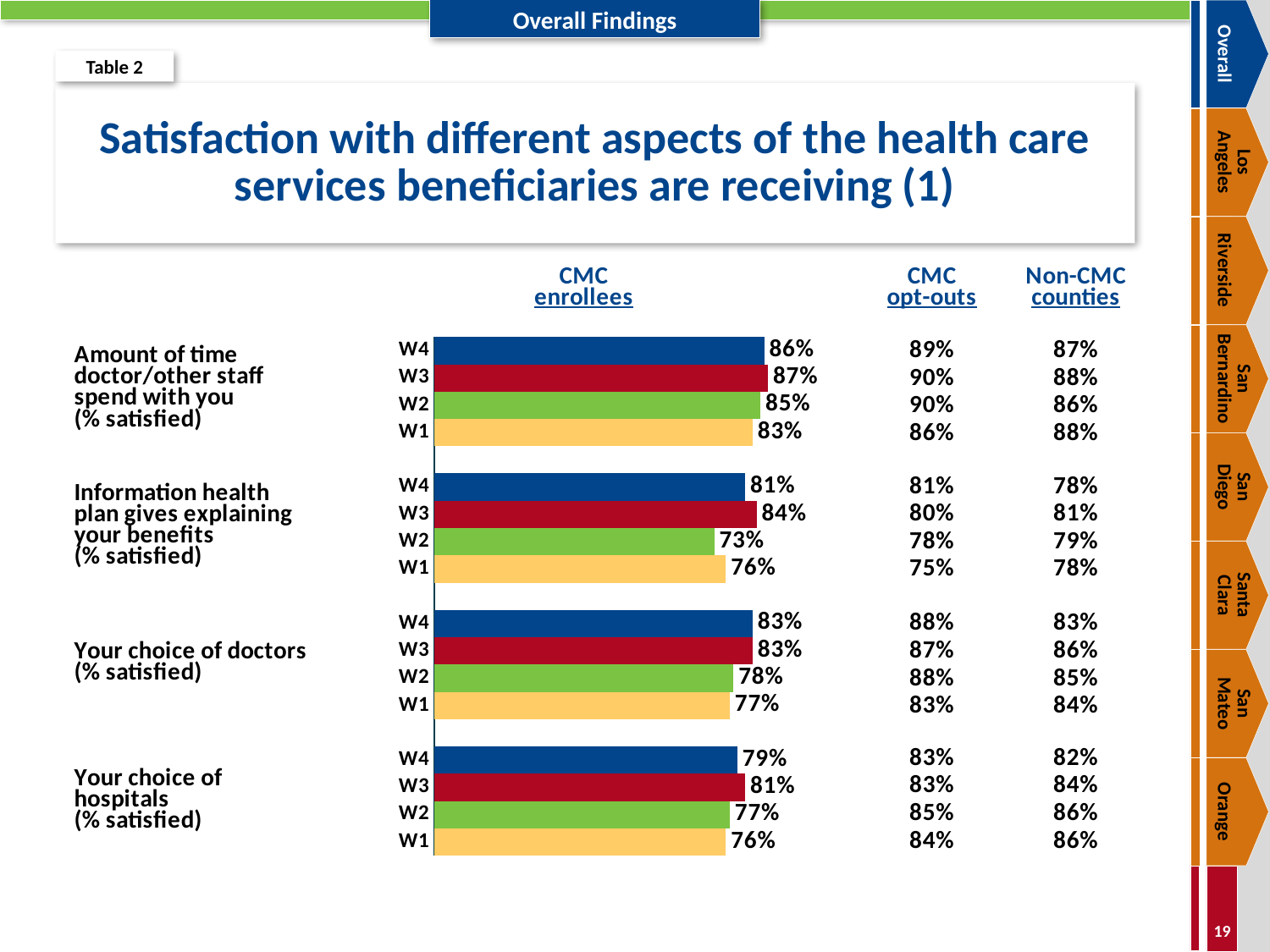
How many waves (bars) are shown for each aspect in the CMC enrollees chart? 4 What colour are the W3 bars in the CMC enrollees chart? Red What is the CMC enrollees value for W2 under "Information health plan gives explaining your benefits"? 73% For "Amount of time doctor/other staff spend with you", what is the difference between the W3 and W1 CMC enrollees values? 4 percentage points Which is larger for CMC enrollees at W4: "Your choice of doctors" or "Your choice of hospitals"? Your choice of doctors What kind of chart is used to show the CMC enrollees values? Bar chart For "Your choice of hospitals", which wave has the highest CMC enrollees bar? W3 For "Information health plan gives explaining your benefits", how much higher is the W3 CMC enrollees value than the W2 value? 11 percentage points What is the CMC enrollees value for W4 under "Amount of time doctor/other staff spend with you"? 86% For "Information health plan gives explaining your benefits", which wave has the lowest CMC enrollees bar? W2 Across the four aspects, which has the highest W4 CMC enrollees bar? Amount of time doctor/other staff spend with you What is the CMC enrollees value for W1 under "Your choice of doctors"? 77%